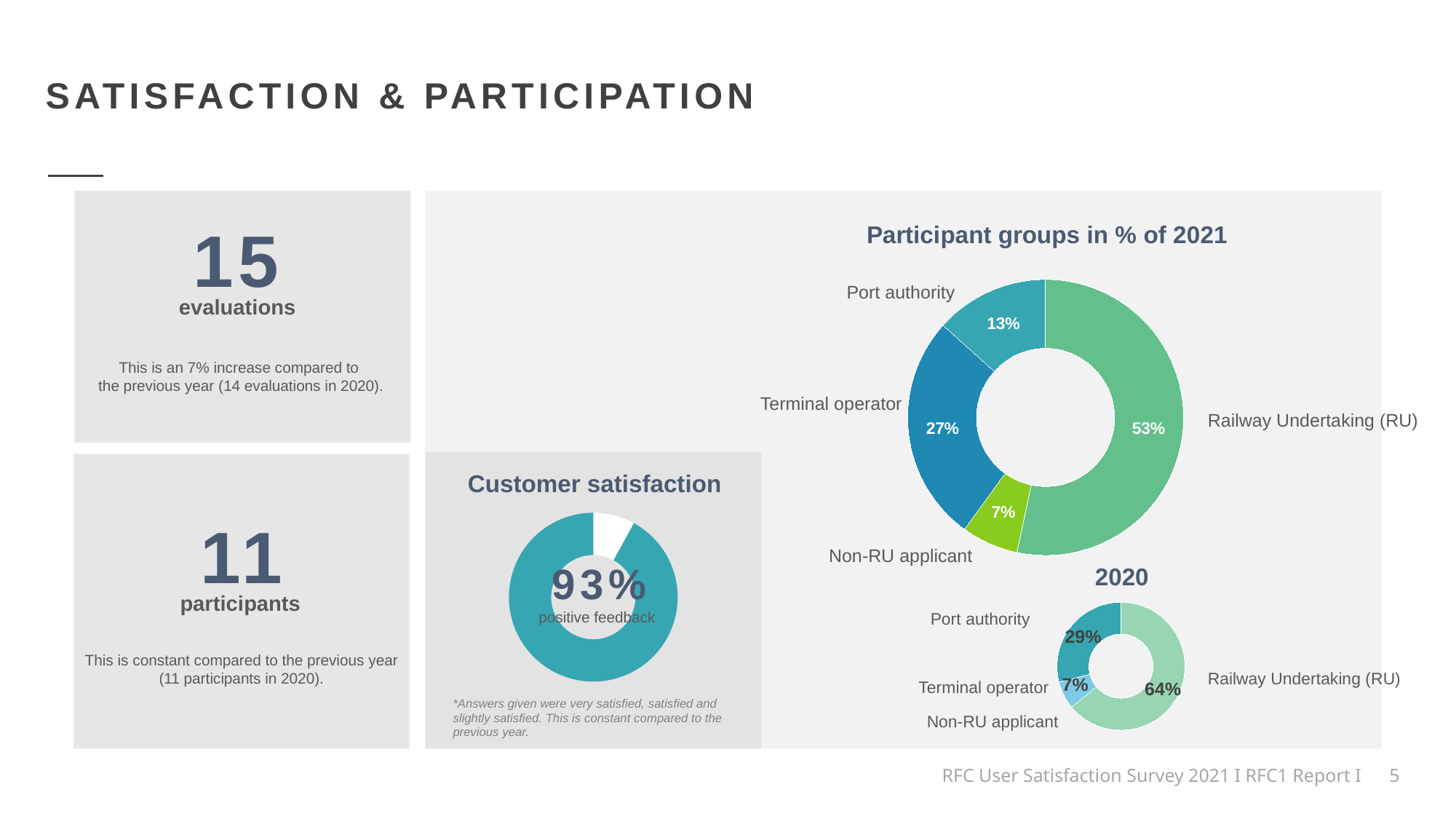
In the 'Customer satisfaction' chart, what percentage of feedback was positive? 93% How many participant groups are labelled in the 'Participant groups in % of 2021' chart? 4 What kind of chart is the 'Participant groups in % of 2021' chart? Donut (pie) chart In the 'Participant groups in % of 2021' chart, which participant group has the smallest share? Non-RU applicant In the 'Participant groups in % of 2021' chart, which participant group has the largest share? Railway Undertaking (RU) In the '2020' chart, what share is Port authority? 29% In the 'Participant groups in % of 2021' chart, what share is Terminal operator? 27% In the '2020' chart, what share is Railway Undertaking (RU)? 64% In the 'Participant groups in % of 2021' chart, which is larger: Port authority or Terminal operator? Terminal operator In the 'Participant groups in % of 2021' chart, what share is Railway Undertaking (RU)? 53% In the 'Participant groups in % of 2021' chart, what share is Port authority? 13% In the 'Participant groups in % of 2021' chart, what is the difference in percentage points between Railway Undertaking (RU) and Terminal operator? 26 percentage points